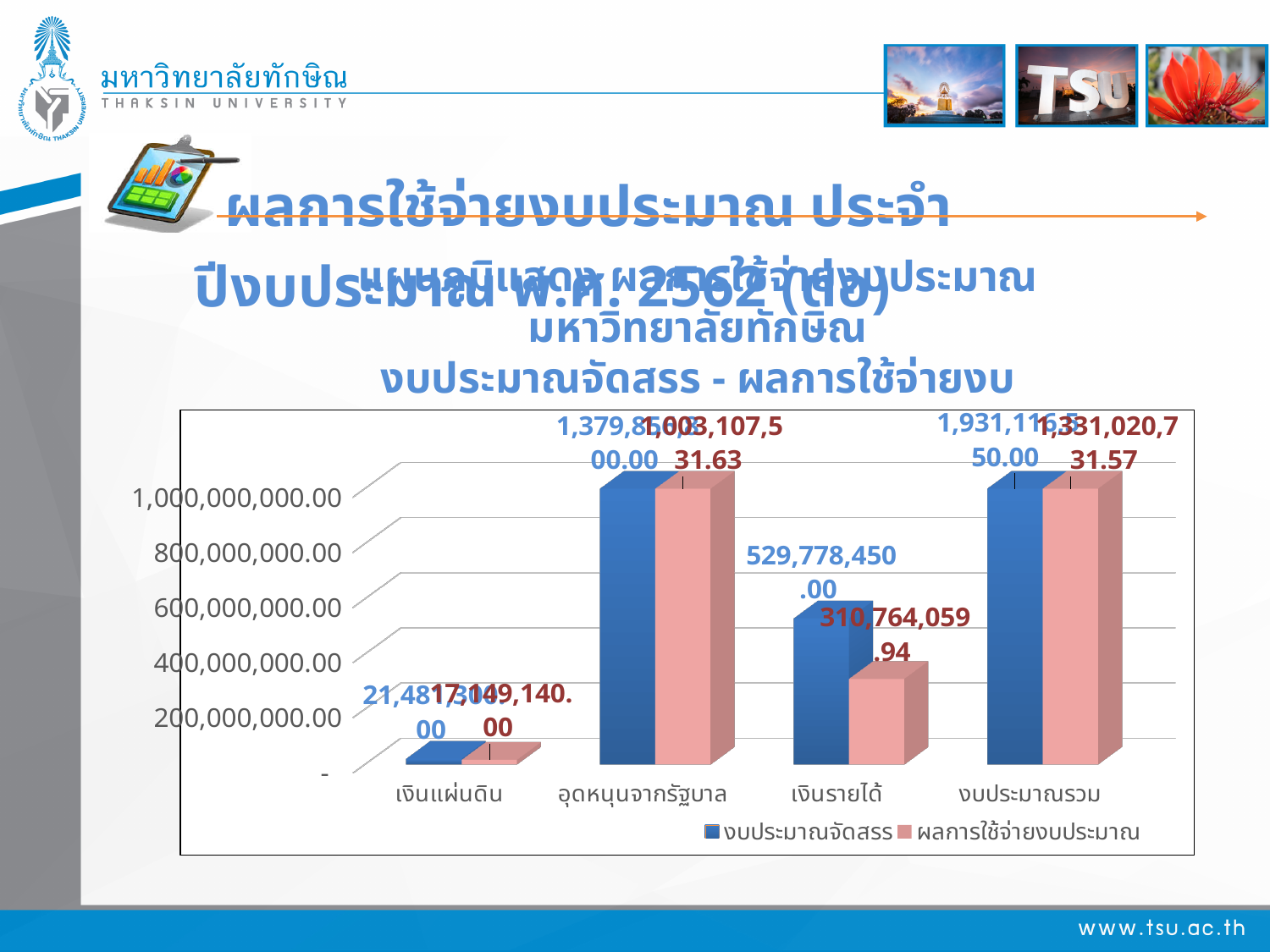
What is the งบประมาณจัดสรร value for เงินรายได้? 529,778,450.00 Which category has the highest งบประมาณจัดสรร value? งบประมาณรวม Is the ผลการใช้จ่ายงบประมาณ value for เงินรายได้ greater or less than 400,000,000.00? less Which series is shown in blue in the chart legend? งบประมาณจัดสรร What kind of chart is shown on the slide? bar chart How many categories are shown on the x axis of the chart? 4 What is the difference between งบประมาณจัดสรร and ผลการใช้จ่ายงบประมาณ for เงินรายได้? 219,014,390.06 Which category has the lowest ผลการใช้จ่ายงบประมาณ value? เงินแผ่นดิน Is the งบประมาณจัดสรร value for อุดหนุนจากรัฐบาล greater or less than 1,000,000,000.00? greater How many series does the chart legend list? 2 For เงินรายได้, which is larger: งบประมาณจัดสรร or ผลการใช้จ่ายงบประมาณ? งบประมาณจัดสรร What is the ผลการใช้จ่ายงบประมาณ value for เงินรายได้? 310,764,059.94